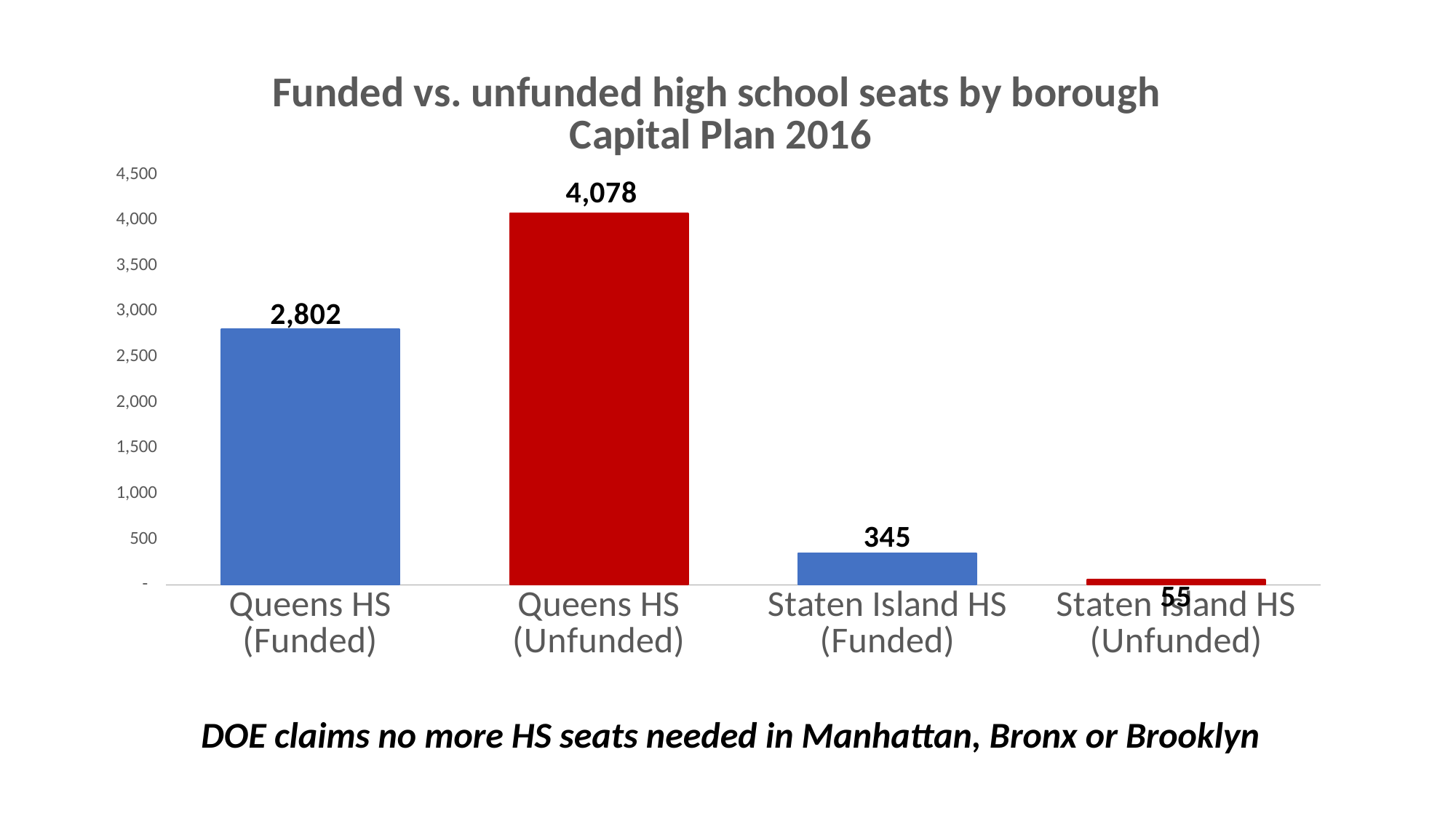
Which category has the highest value? Queens HS (Unfunded) What is the value for Staten Island HS (Unfunded)? 55 What is the difference between Staten Island HS (Funded) and Staten Island HS (Unfunded)? 290 How many categories are shown on the chart? 4 What is the value for Staten Island HS (Funded)? 345 What is the title of the chart? Funded vs. unfunded high school seats by borough Capital Plan 2016 What is the difference between Queens HS (Unfunded) and Queens HS (Funded)? 1,276 What is the value for Queens HS (Funded)? 2,802 Which is larger, Queens HS (Funded) or Staten Island HS (Funded)? Queens HS (Funded) What kind of chart is this? Bar chart What is the value for Queens HS (Unfunded)? 4,078 Which category has the lowest value? Staten Island HS (Unfunded)